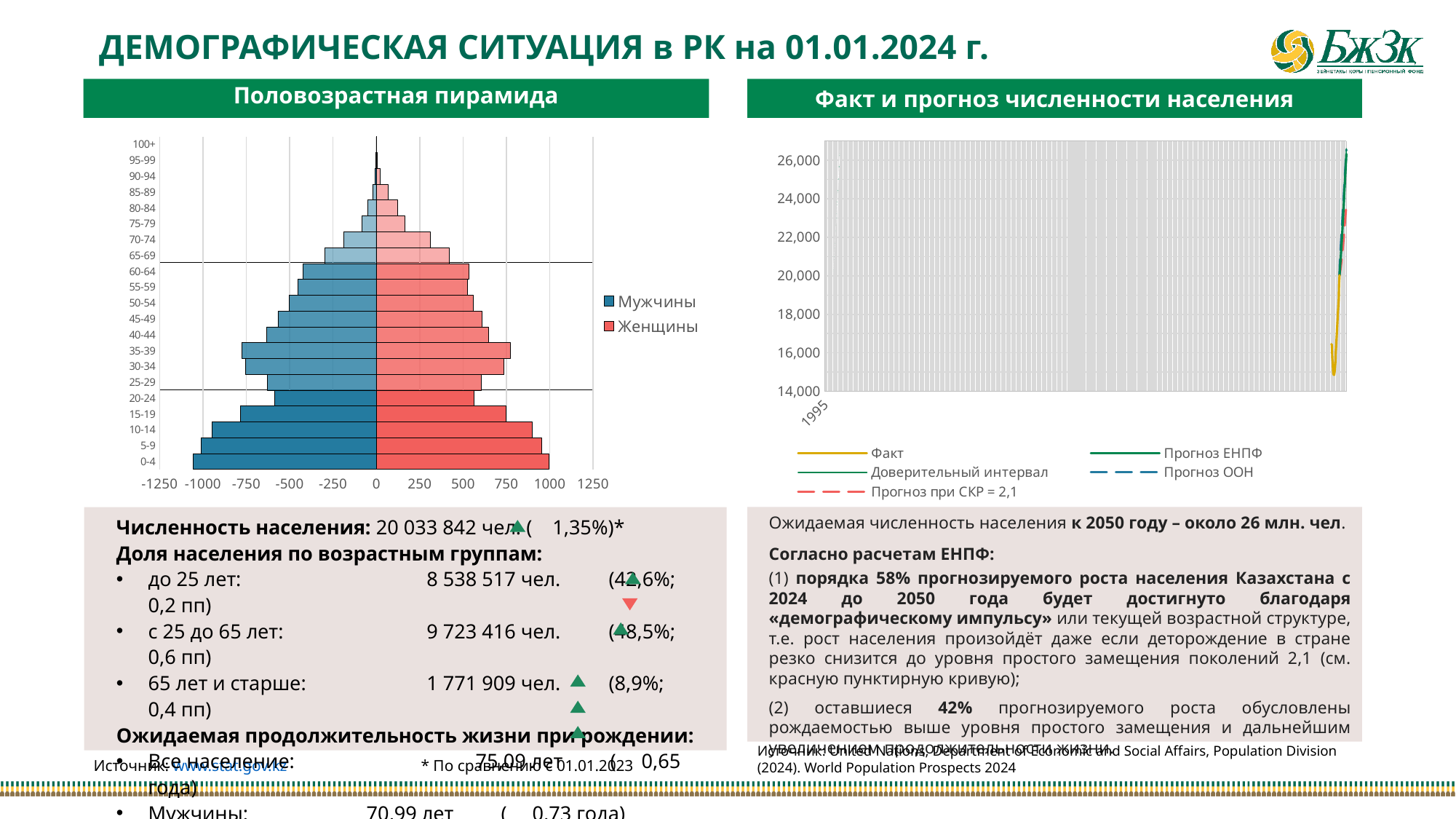
In the 'Половозрастная пирамида' chart, is the Женщины value for the 5-9 age group greater or less than 750? greater How many age-group categories are shown on the 'Половозрастная пирамида' chart? 21 How many series does the legend of the 'Факт и прогноз численности населения' chart list? 5 In the 'Половозрастная пирамида' chart, which age group has the shortest bars? 100+ What kind of chart is the 'Половозрастная пирамида' chart? bar chart What kind of chart is the 'Факт и прогноз численности населения' chart? line chart What are the two legend entries of the 'Половозрастная пирамида' chart? Мужчины, Женщины In the 'Половозрастная пирамида' chart, which age group has the longest bar for Женщины? 0-4 In the 'Половозрастная пирамида' chart, is the Женщины value for the 65-69 age group greater or less than 500? less How many series does the legend of the 'Половозрастная пирамида' chart list? 2 In the 'Факт и прогноз численности населения' chart, does the Прогноз ЕНПФ line rise or fall over time? rise